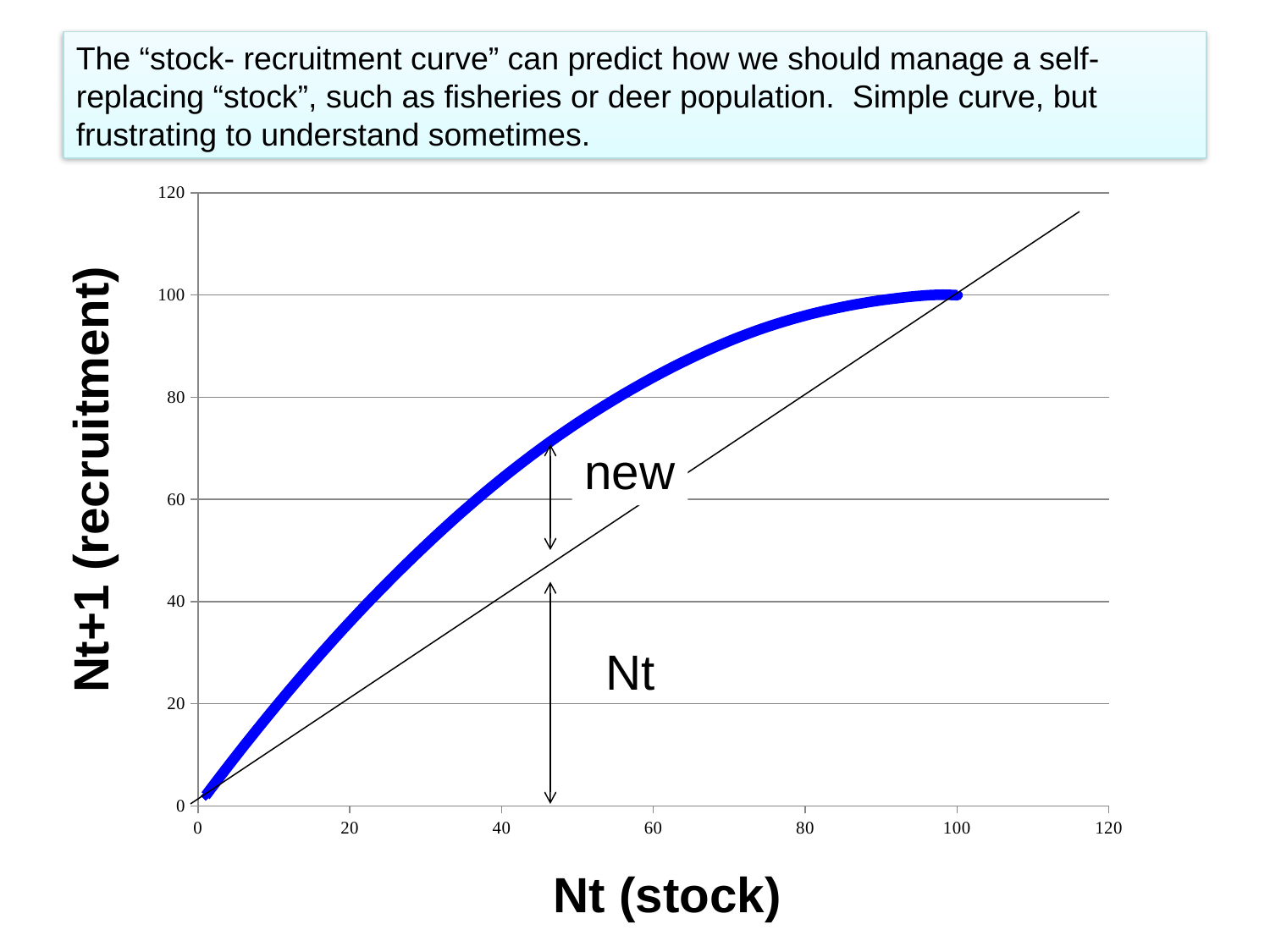
What is the label of the y axis? Nt+1 (recruitment) What is the Nt+1 (recruitment) value at the right end of the thick blue curve? 100 What kind of chart is shown on the slide? line chart Is the Nt+1 value of the thick blue curve at Nt = 40 greater or less than 60? greater Is the Nt+1 value of the thick blue curve at Nt = 20 greater or less than 20? greater What is the label of the x axis? Nt (stock) At Nt = 40, which is higher: the thick blue curve or the thin straight line? the thick blue curve How many lines are plotted on the chart? 2 Is the Nt+1 value of the thick blue curve at Nt = 80 greater or less than 80? greater Does the thick blue curve rise or fall as Nt (stock) increases? rise At what value of Nt (stock) does the thick blue curve end? 100 What is the highest tick value shown on the y axis? 120